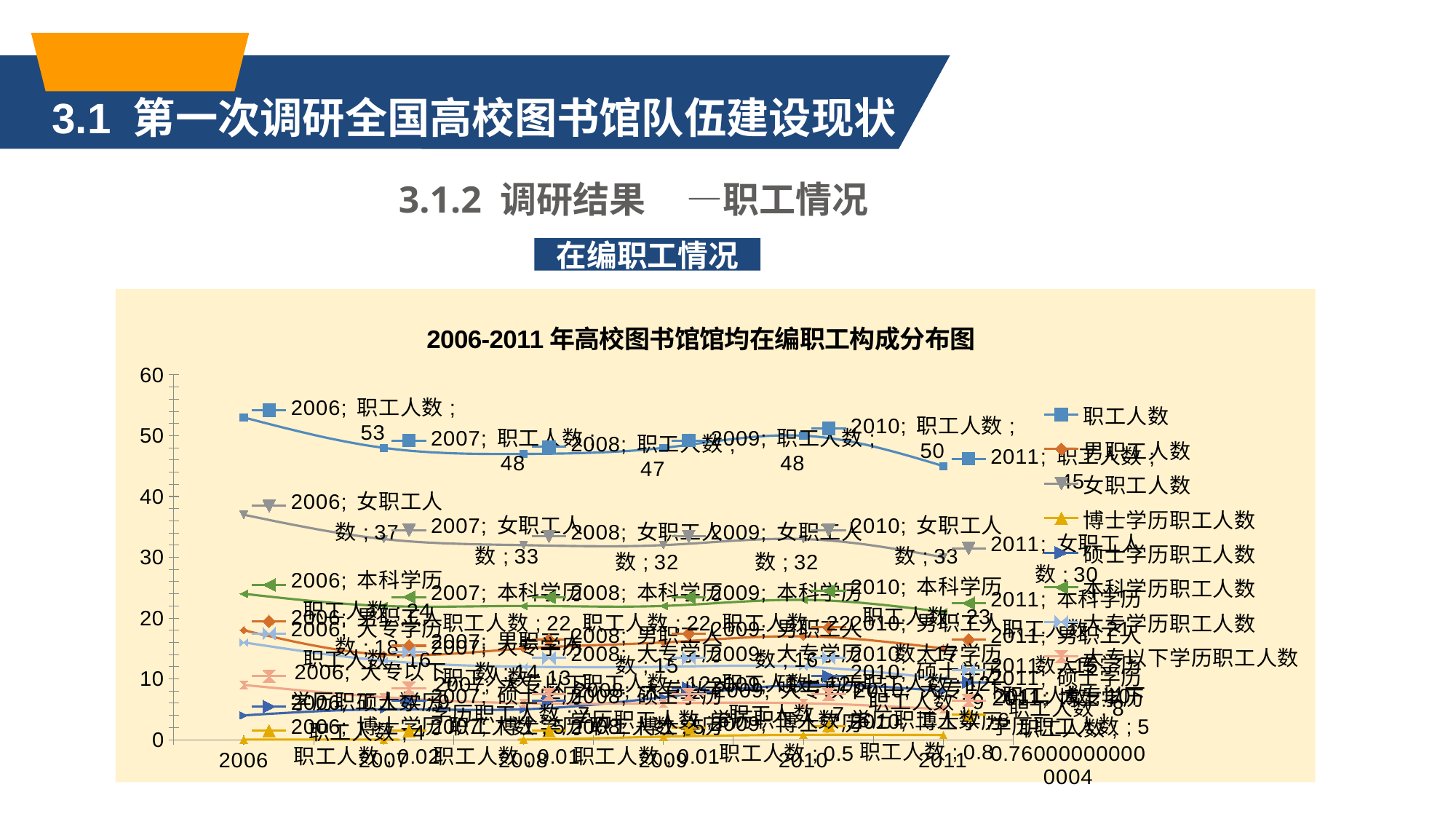
How many years are plotted along the x axis? 6 What kind of chart is shown on the slide? line chart How many series does the chart legend list? 8 What is the value of 职工人数 in 2006? 53 Is the value for 博士学历职工人数 in 2011 greater or less than 10? less Which is larger: 女职工人数 in 2006 or 女职工人数 in 2010? 2006 In which year is 职工人数 highest? 2006 What is the value of 女职工人数 in 2008? 32 What is the difference between 职工人数 in 2006 and in 2011? 8 What is the value of 本科学历职工人数 in 2010? 23 In which year is 女职工人数 lowest? 2011 What is the value of 职工人数 in 2011? 45